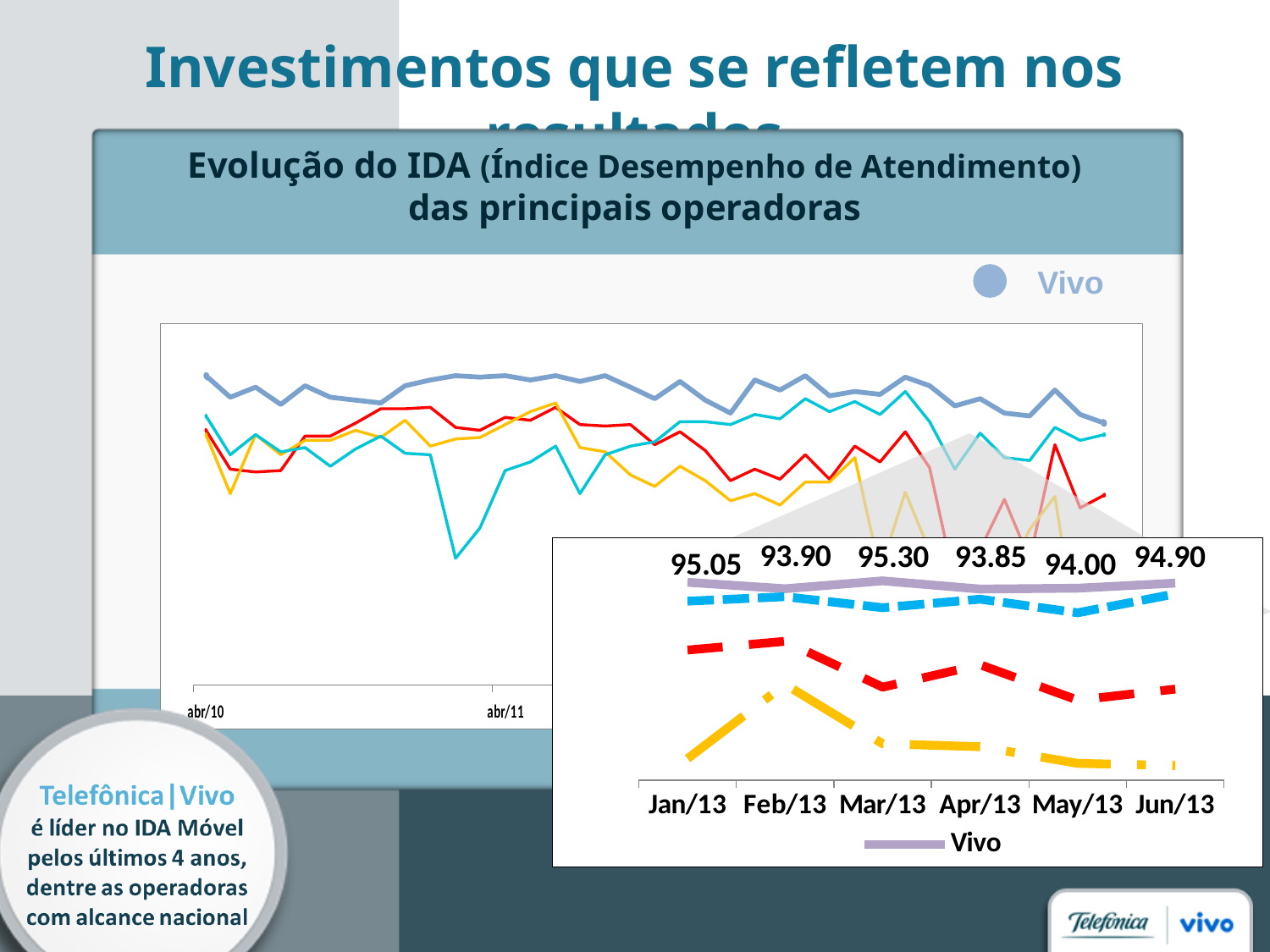
In the inset chart at the bottom right, how many series does the legend list? 1 In the inset chart at the bottom right, what is the Vivo value for Mar/13? 95.30 In the inset chart at the bottom right, does the Vivo value rise or fall from Apr/13 to Jun/13? Rise In the inset chart at the bottom right, how many months are shown on the x axis? 6 In the inset chart at the bottom right, what is the difference between the Vivo values for Jan/13 and Feb/13? 1.15 In the inset chart at the bottom right, what is the Vivo value for Jan/13? 95.05 What kind of chart is the inset chart at the bottom right? Line chart In the inset chart at the bottom right, which month has the lowest Vivo value? Apr/13 In the inset chart at the bottom right, which is larger, the Vivo value for Jan/13 or for Jun/13? Jan/13 In the inset chart at the bottom right, what is the Vivo value for Jun/13? 94.90 In the inset chart at the bottom right, which month has the highest Vivo value? Mar/13 In the inset chart at the bottom right, what is the difference between the Vivo values for Mar/13 and Apr/13? 1.45